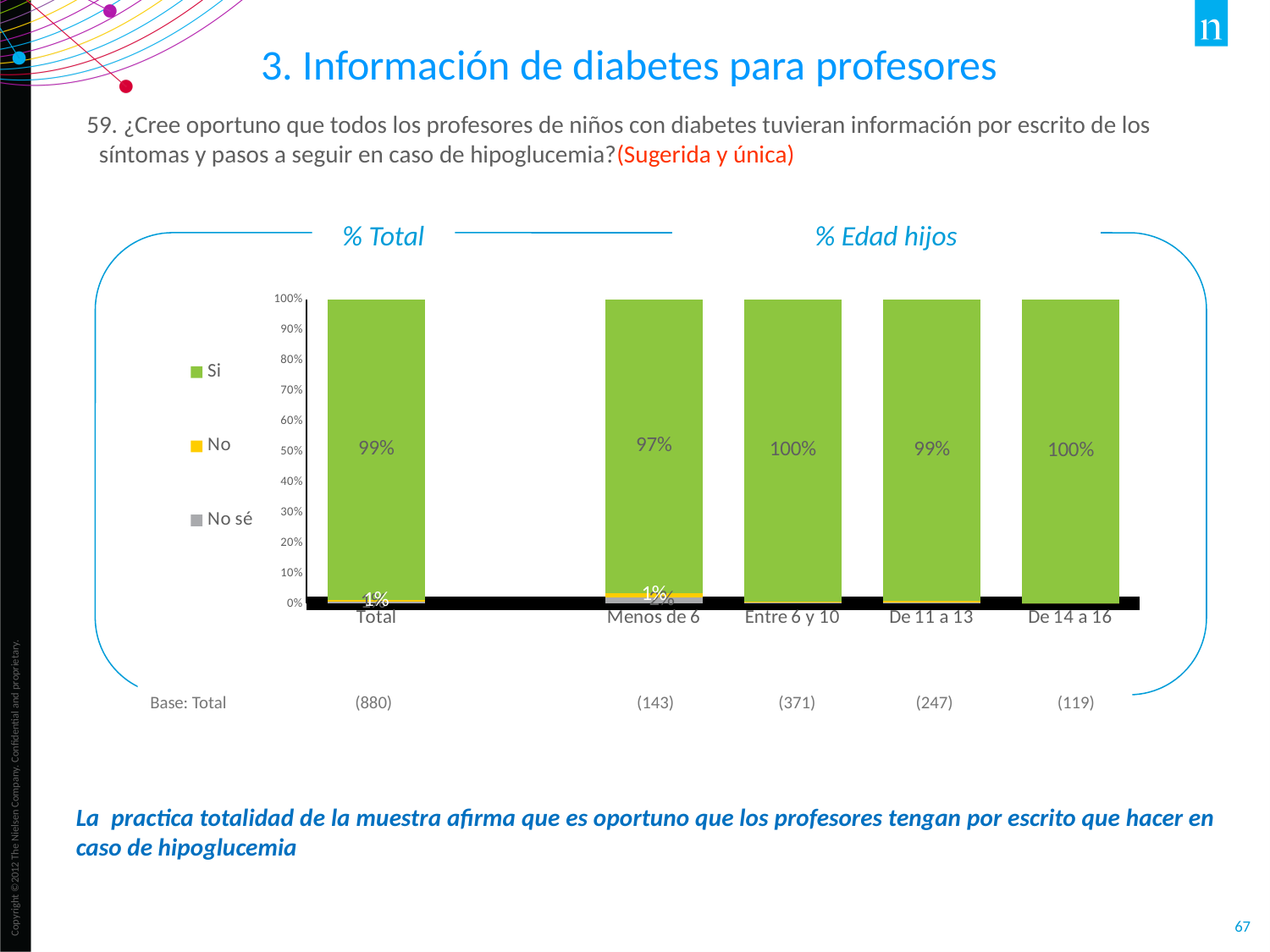
How many series does the legend list? 3 What is the value of the "Si" series for the "De 11 a 13" category? 99% What is the difference between the "Si" value for Total and the "Si" value for "Menos de 6"? 2 percentage points What is the value of the "Si" series for the Total category? 99% What is the value of the "Si" series for the "Entre 6 y 10" category? 100% What is the value of the "Si" series for the "Menos de 6" category? 97% What is the value of the "Si" series for the "De 14 a 16" category? 100% Which has a larger "Si" value: "Menos de 6" or "De 11 a 13"? De 11 a 13 Which category has the lowest value for the "Si" series? Menos de 6 Is the "Si" value for "Menos de 6" greater or less than 90%? greater What kind of chart is shown on the slide? Stacked bar chart How many categories are shown on the x axis of the chart? 5